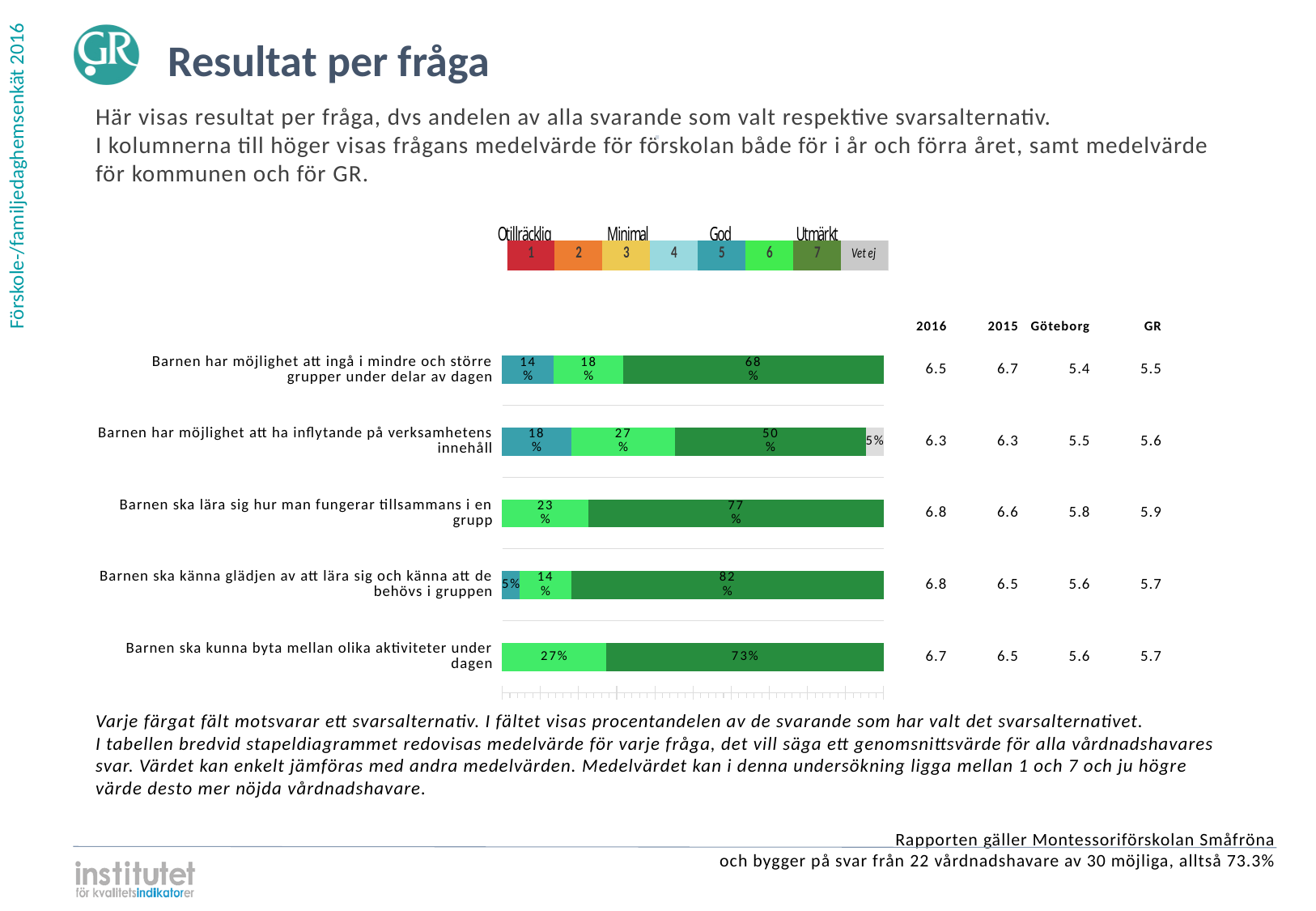
What is the "Vet ej" share for "Barnen har möjlighet att ha inflytande på verksamhetens innehåll"? 5% How many questions (categories) are plotted in the bar chart? 5 Which question has the lowest share of respondents choosing answer 7 (dark green)? Barnen har möjlighet att ha inflytande på verksamhetens innehåll What kind of chart is shown on the slide? Stacked bar chart What percentage of respondents chose answer 5 (teal) for "Barnen har möjlighet att ha inflytande på verksamhetens innehåll"? 18% What is the difference between the answer-7 share for "Barnen ska lära sig hur man fungerar tillsammans i en grupp" and for "Barnen ska kunna byta mellan olika aktiviteter under dagen"? 4 percentage points How many answer alternatives does the legend above the chart list? 8 Which question has the highest share of respondents choosing answer 7 (dark green)? Barnen ska känna glädjen av att lära sig och känna att de behövs i gruppen Which is larger: the answer-6 share for "Barnen har möjlighet att ha inflytande på verksamhetens innehåll" or for "Barnen ska lära sig hur man fungerar tillsammans i en grupp"? Barnen har möjlighet att ha inflytande på verksamhetens innehåll What percentage of respondents chose answer 6 (light green) for "Barnen ska kunna byta mellan olika aktiviteter under dagen"? 27% What is the combined share of answers 5, 6 and 7 for "Barnen har möjlighet att ingå i mindre och större grupper under delar av dagen"? 100% What percentage of respondents chose answer 7 (dark green) for "Barnen ska känna glädjen av att lära sig och känna att de behövs i gruppen"? 82%